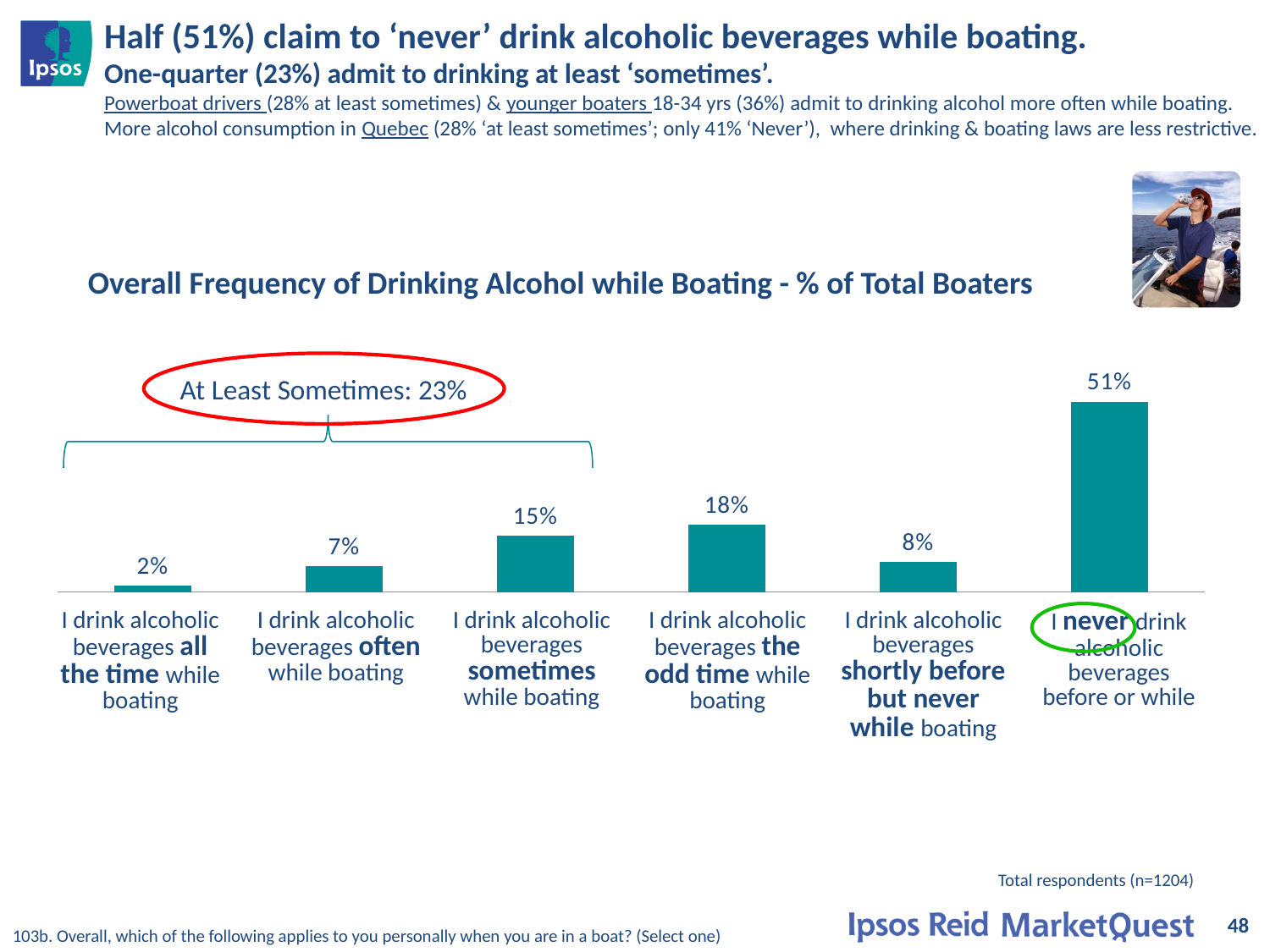
Which category has the lowest percentage of total boaters? I drink alcoholic beverages all the time while boating What is the title of the chart? Overall Frequency of Drinking Alcohol while Boating - % of Total Boaters What percentage of boaters say they drink alcoholic beverages sometimes while boating? 15% What type of chart is used on this slide? Bar chart What is the difference in percentage points between boaters who drink the odd time and those who drink often? 11 Which is larger: the share who drink sometimes while boating or the share who drink shortly before but never while boating? Sometimes while boating What is the combined percentage for the 'all the time', 'often' and 'sometimes' categories? 24% Which category has the highest percentage of total boaters? I never drink alcoholic beverages before or while boating What percentage of boaters say they drink alcoholic beverages all the time while boating? 2% What percentage of boaters say they drink alcoholic beverages shortly before but never while boating? 8% What percentage of boaters say they never drink alcoholic beverages before or while boating? 51% How many categories are shown in the chart? 6